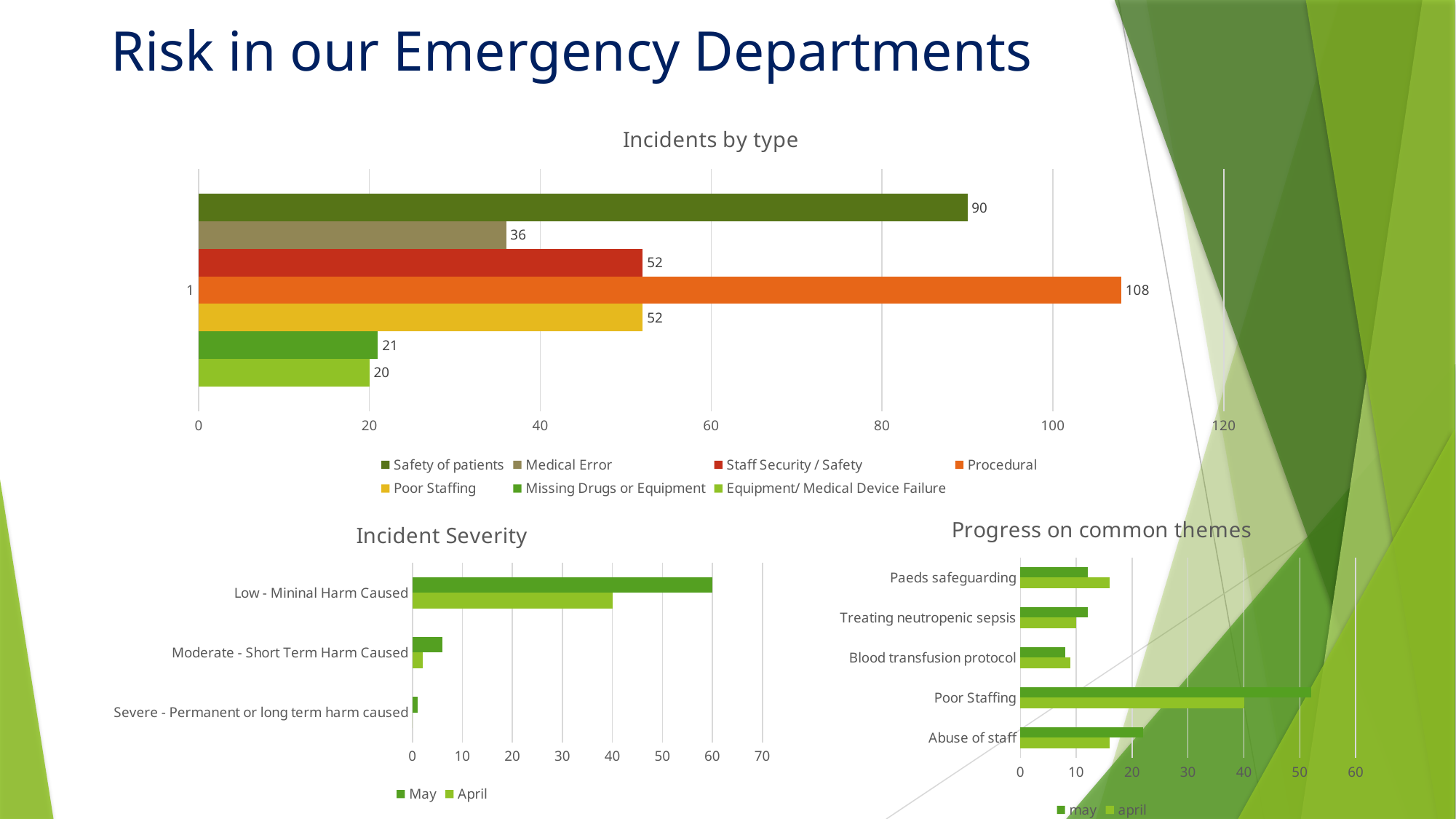
In the 'Incidents by type' chart, what is the value for Procedural? 108 In the 'Incidents by type' chart, which is larger: Medical Error or Staff Security / Safety? Staff Security / Safety In the 'Incidents by type' chart, which incident type has the highest value? Procedural In the 'Incidents by type' chart, what is the value for Medical Error? 36 How many series does the legend of the 'Incidents by type' chart list? 7 In the 'Incidents by type' chart, which incident type has the lowest value? Equipment/ Medical Device Failure In the 'Incidents by type' chart, what is the difference between Procedural and Safety of patients? 18 In the 'Progress on common themes' chart, which theme has the highest value for may? Poor Staffing In the 'Incident Severity' chart, is the May value for 'Low - Mininal Harm Caused' greater or less than 50? greater How many categories are shown in the 'Progress on common themes' chart? 5 How many series does the legend of the 'Incident Severity' chart list? 2 What kind of chart is 'Incident Severity'? Bar chart